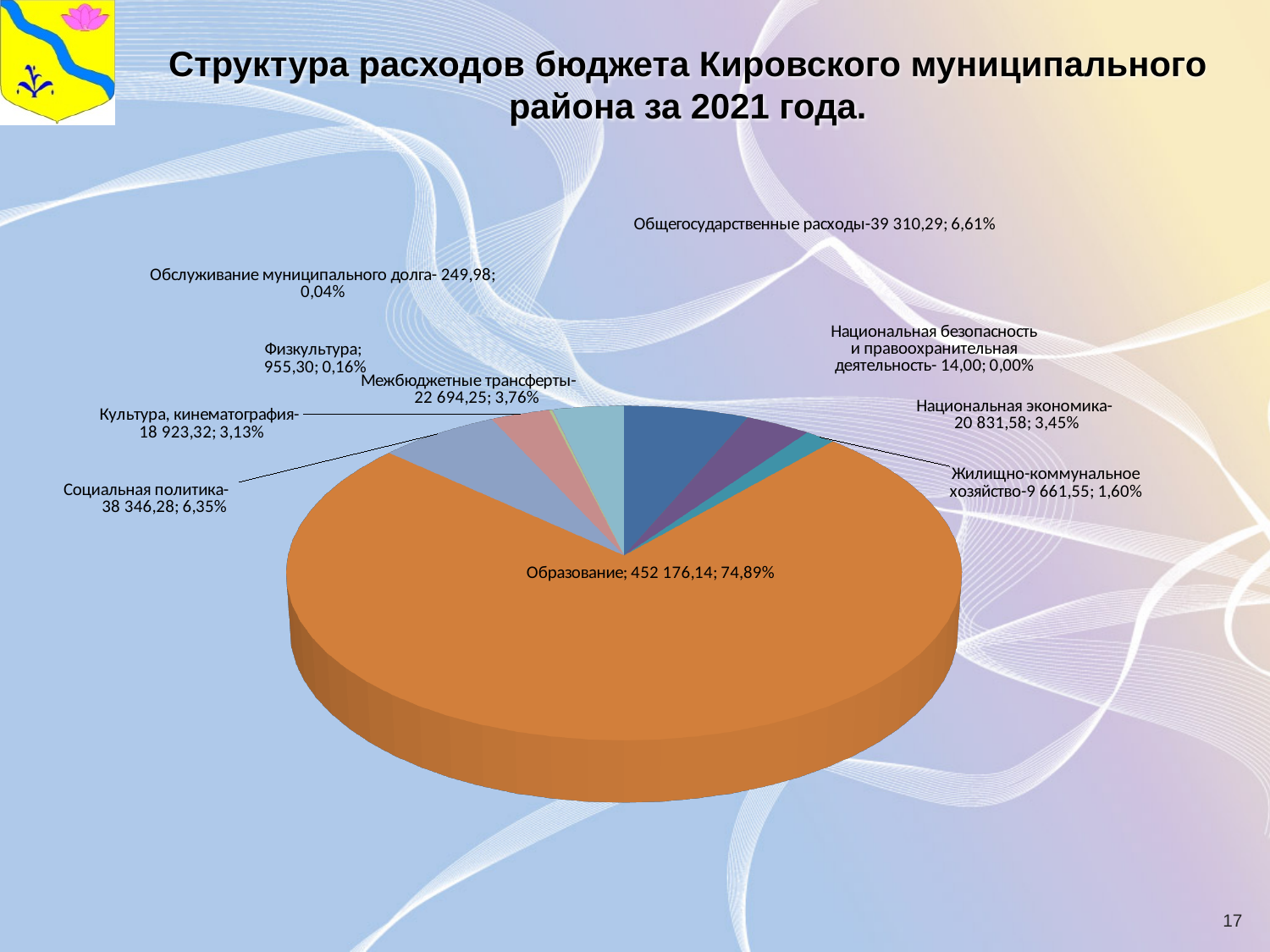
Which category has the smallest value in the pie chart? Национальная безопасность и правоохранительная деятельность Which is larger: Общегосударственные расходы or Национальная экономика? Общегосударственные расходы What is the difference between the values for Общегосударственные расходы and Социальная политика? 964,01 How many categories (slices) does the pie chart show? 10 What is the value shown for Образование? 452 176,14 What year does the chart title say the budget expenditure structure refers to? 2021 What is the value shown for Обслуживание муниципального долга? 249,98 Which category has the largest share of the budget expenditures? Образование What share of the pie does Социальная политика account for? 6,35% What is the value shown for Межбюджетные трансферты? 22 694,25 What kind of chart is shown on the slide? Pie chart What percentage is shown for Жилищно-коммунальное хозяйство? 1,60%